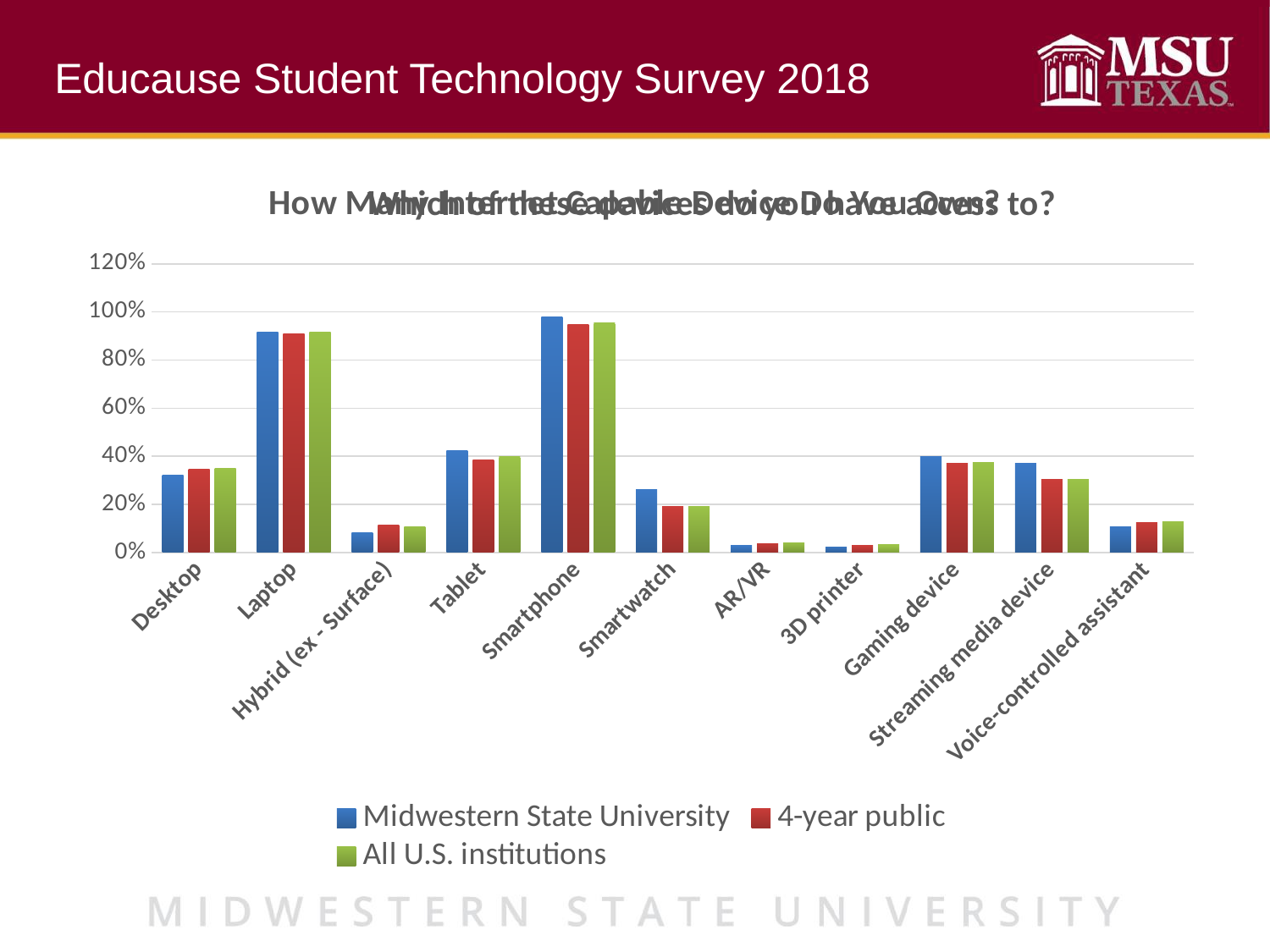
What kind of chart is shown on the slide? bar chart Which device category has the highest value for Midwestern State University? Smartphone How many device categories are shown on the x axis of the chart? 11 Which colour represents Midwestern State University in the chart's legend? blue Is the Midwestern State University value for Laptop greater or less than 80%? greater How many series does the chart's legend list? 3 Is the Midwestern State University value for Desktop greater or less than 20%? greater Is the Midwestern State University value for Smartwatch greater or less than 20%? greater For Smartwatch, which is larger: the Midwestern State University value or the 4-year public value? Midwestern State University For Midwestern State University, which is larger: the value for Smartphone or the value for Laptop? Smartphone